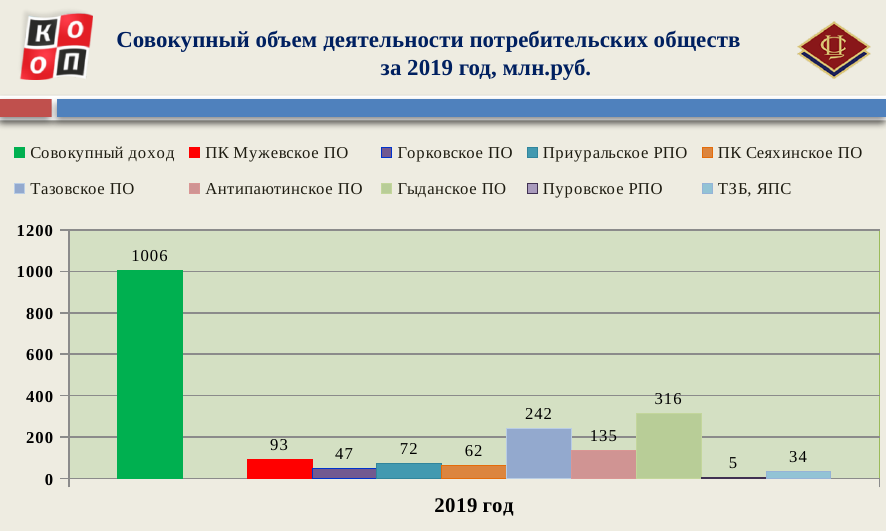
What is the value for Тазовское ПО? 242 Which is larger, the value for ПК Мужевское ПО or the value for Приуральское РПО? ПК Мужевское ПО Excluding Совокупный доход, which series has the highest value? Гыданское ПО What is the value for Гыданское ПО? 316 Is the value for Антипаютинское ПО greater or less than 200? less What is the difference between the values for Гыданское ПО and Тазовское ПО? 74 What kind of chart is shown on the slide? bar chart What is the x-axis label of the chart? 2019 год Which series has the lowest value? Пуровское РПО What is the value for Пуровское РПО? 5 How many series does the legend list? 10 What is the value for Совокупный доход? 1006